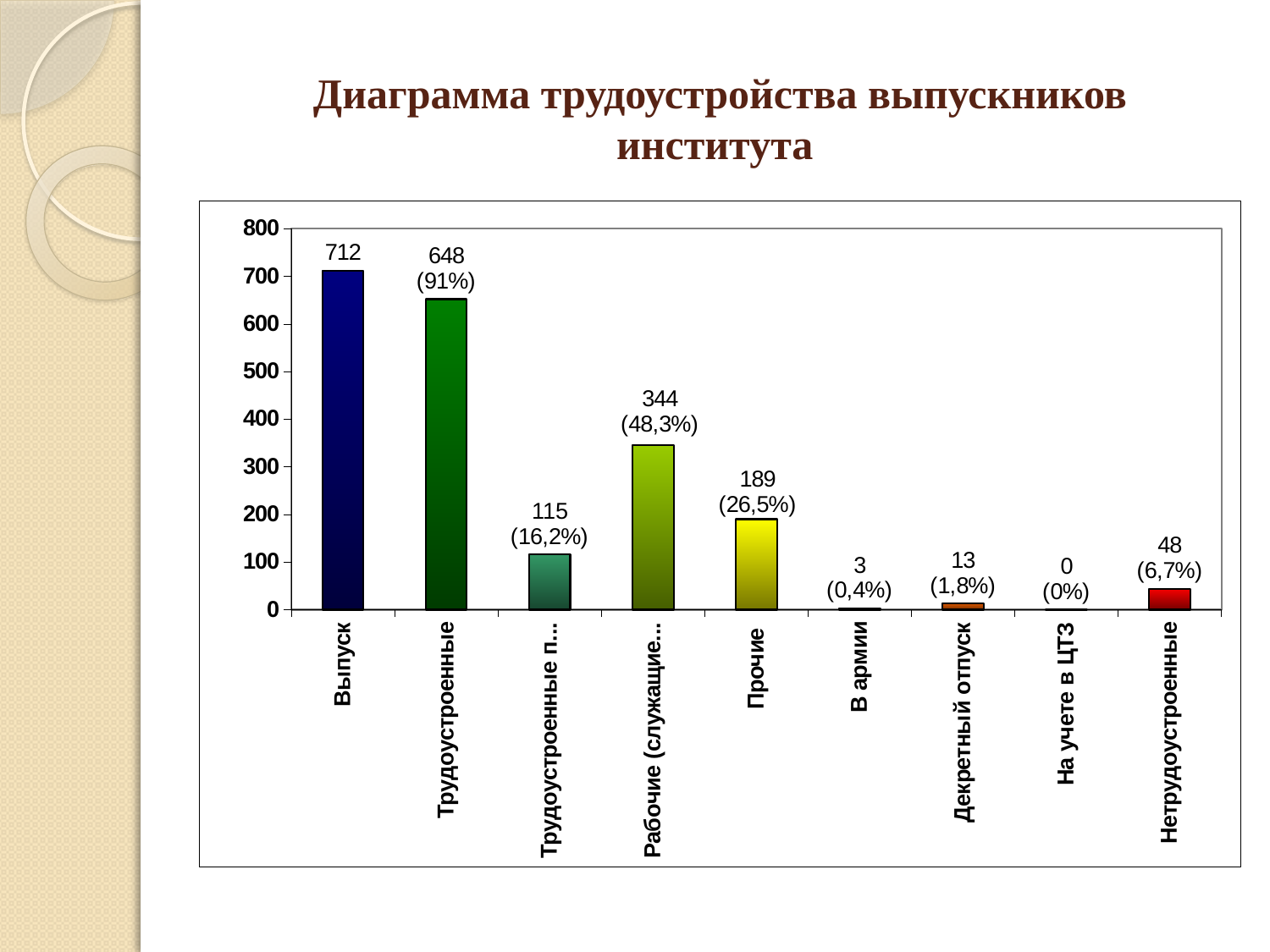
Which is larger, the value for Прочие or the value for Нетрудоустроенные? Прочие What is the difference between the values for Выпуск and Трудоустроенные? 64 What kind of chart is shown on the slide? Bar chart How many categories are shown on the x axis? 9 What is the value for Прочие? 189 What is the value for Выпуск? 712 What is the value for Нетрудоустроенные? 48 What is the value for Декретный отпуск? 13 What percentage is printed above the bar for Трудоустроенные? 91% Which category has the highest value? Выпуск What is the value for Трудоустроенные? 648 Which category has the lowest value? На учете в ЦТЗ